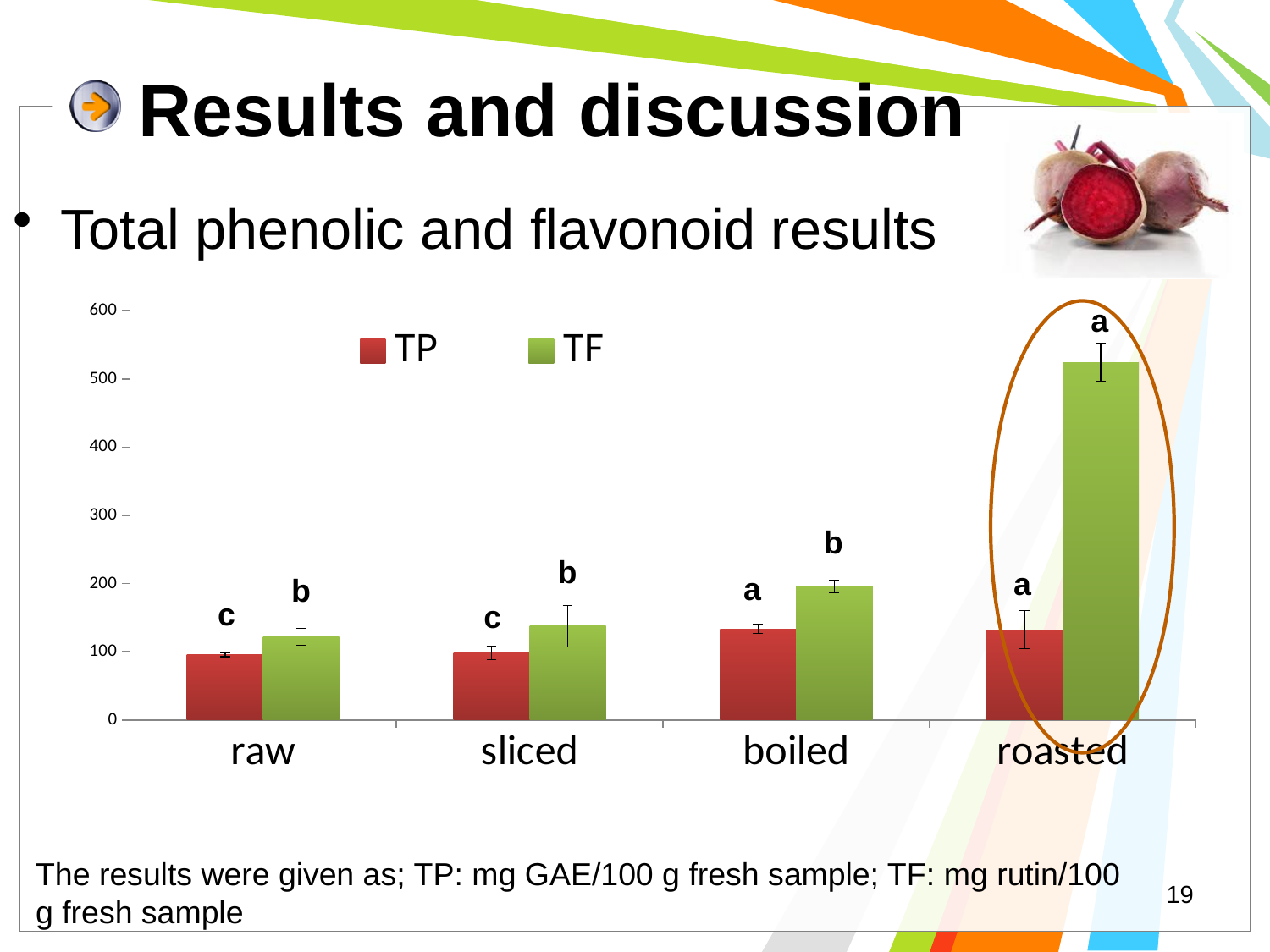
Is the TF value for roasted greater or less than 500? greater Which category has the highest TF value? roasted Is the TF value for sliced greater or less than 200? less What kind of chart is shown on the slide? bar chart Which is larger, the TF value for roasted or the TF value for boiled? roasted Do the TF values rise or fall from raw to roasted along the x axis? rise What colour are the TF bars? green Is the TF value for raw greater or less than 100? greater Which is larger, the TP value for boiled or the TP value for raw? boiled How many categories are shown on the x axis? 4 How many series does the legend list? 2